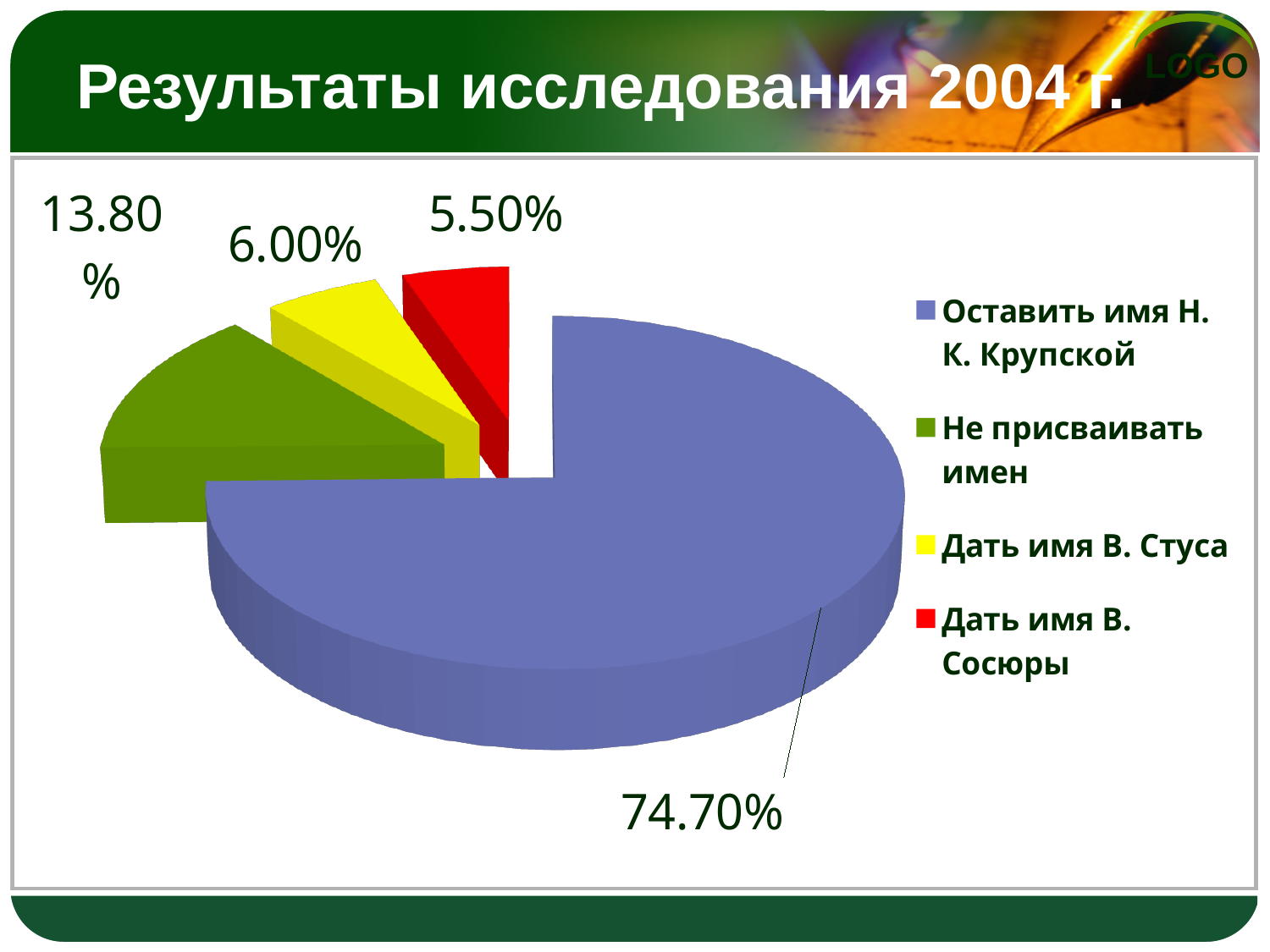
What share of the pie does "Дать имя В. Стуса" have? 6.00% Which category has the largest slice of the pie? Оставить имя Н. К. Крупской What share of the pie does "Не присваивать имен" have? 13.80% What share of the pie does "Оставить имя Н. К. Крупской" have? 74.70% What share of the pie does "Дать имя В. Сосюры" have? 5.50% What kind of chart is shown on the slide? Pie chart Which is larger: the share for "Дать имя В. Стуса" or for "Дать имя В. Сосюры"? Дать имя В. Стуса Which category has the smallest slice of the pie? Дать имя В. Сосюры How many entries does the legend list? 4 What is the difference between the shares for "Оставить имя Н. К. Крупской" and "Не присваивать имен"? 60.90% What is the title of the slide containing the chart? Результаты исследования 2004 г. How many slices does the pie chart have? 4